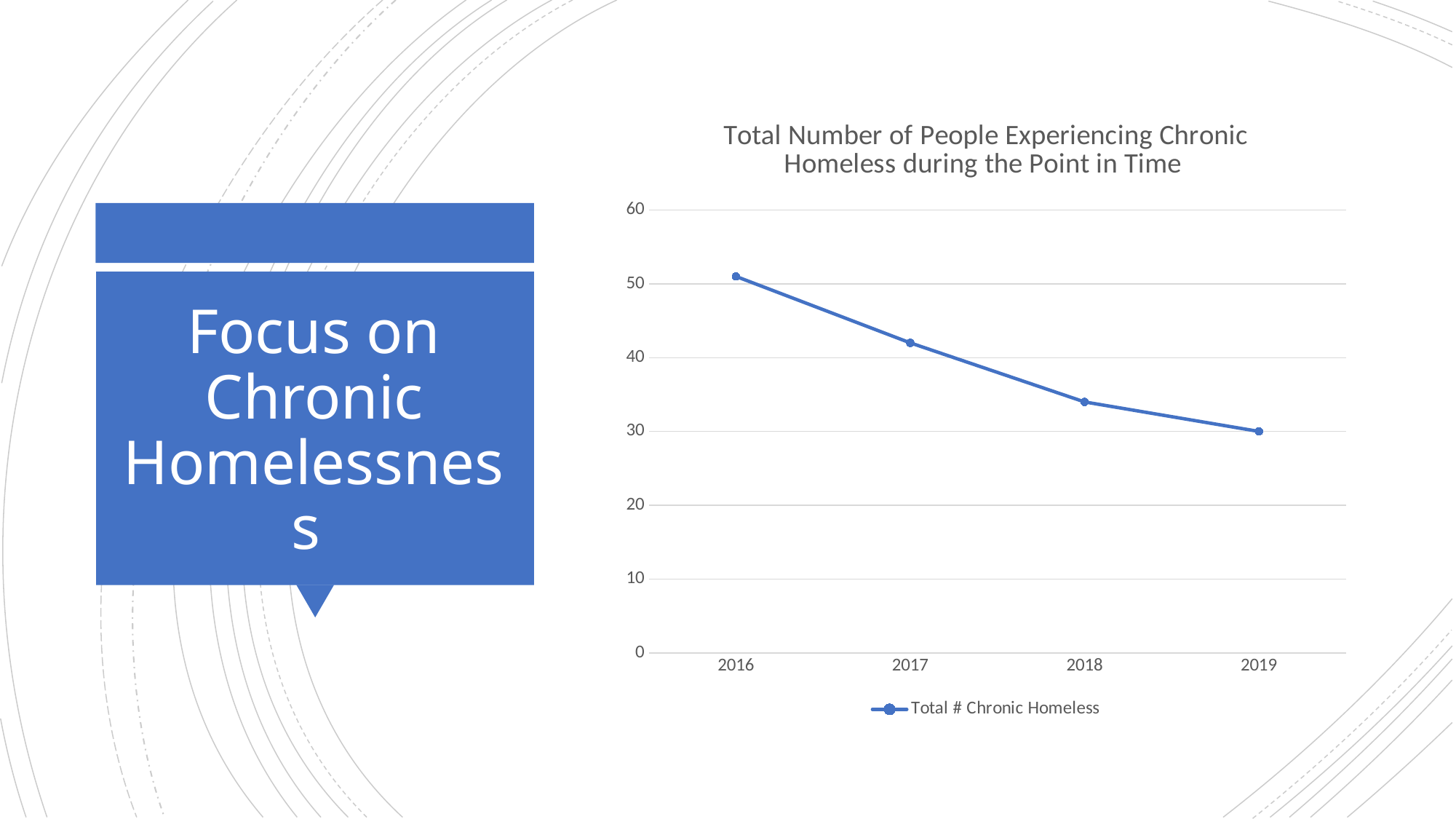
Do the values rise or fall from 2016 to 2019? fall How many years are plotted on the x axis? 4 Is the value for 2017 greater or less than 50? less What is the title of the chart? Total Number of People Experiencing Chronic Homeless during the Point in Time How many series does the legend list? 1 Is the value for 2016 greater or less than 40? greater Which year has a larger value, 2016 or 2019? 2016 What is the name of the series shown in the legend? Total # Chronic Homeless Which year has the highest number of people experiencing chronic homelessness? 2016 Is the value for 2018 greater or less than 40? less Which year has the lowest number of people experiencing chronic homelessness? 2019 What kind of chart is shown on the slide? line chart